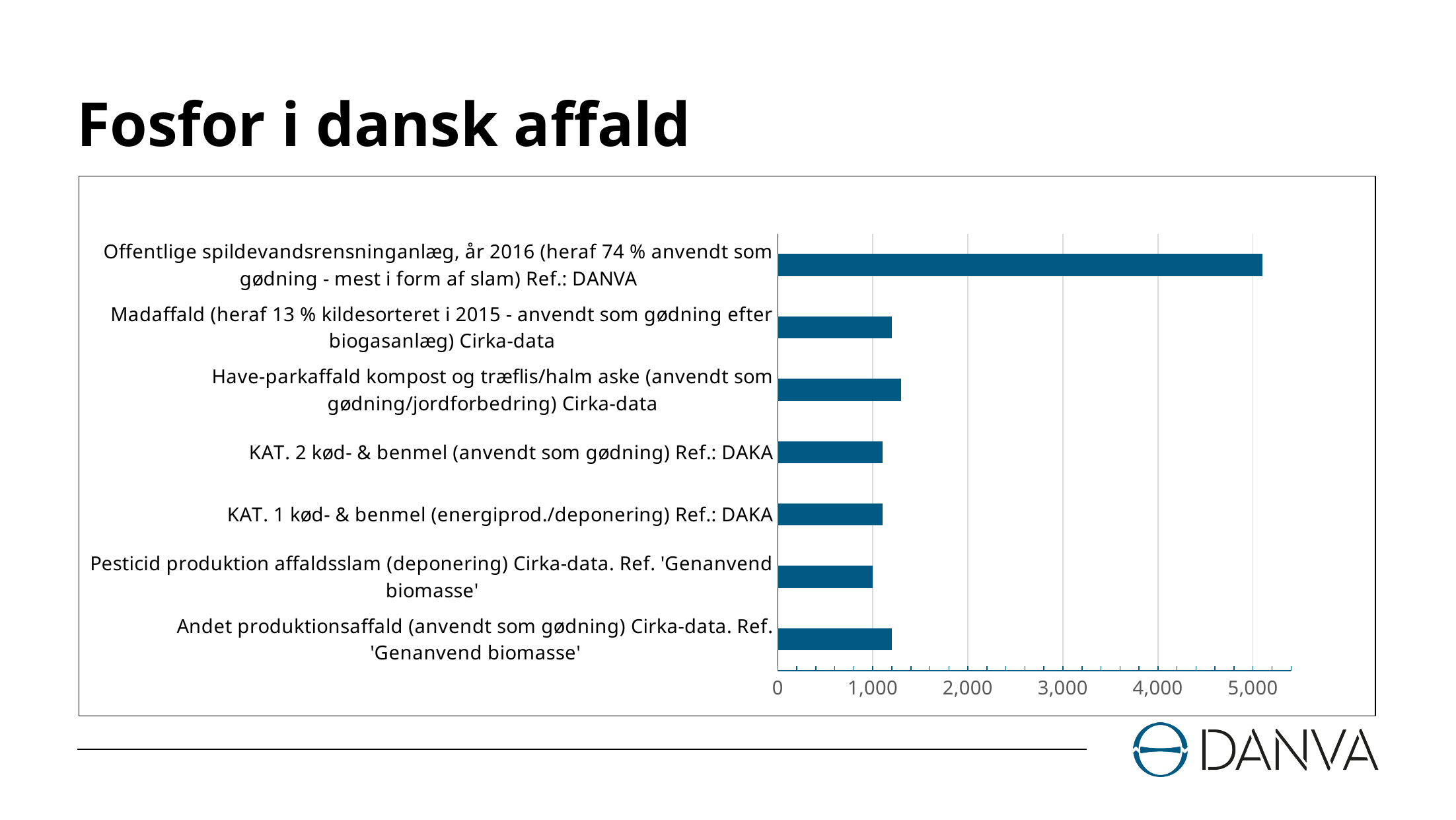
Which category has the highest value in the chart? Offentlige spildevandsrensninganlæg, år 2016 (heraf 74 % anvendt som gødning - mest i form af slam) Ref.: DANVA Is the value for Have-parkaffald kompost og træflis/halm aske greater or less than 1,000? greater Which is larger: the value for Have-parkaffald kompost og træflis/halm aske or the value for Pesticid produktion affaldsslam (deponering)? Have-parkaffald kompost og træflis/halm aske Is the value for Madaffald greater or less than 2,000? less Which is larger: the value for Offentlige spildevandsrensninganlæg, år 2016 or the value for Madaffald? Offentlige spildevandsrensninganlæg, år 2016 How many categories are plotted in the chart? 7 What is the title of the slide containing the chart? Fosfor i dansk affald Is the value for KAT. 1 kød- & benmel (energiprod./deponering) greater or less than 2,000? less What is the highest labelled tick value on the horizontal axis of the chart? 5,000 What kind of chart is shown on the slide? bar chart